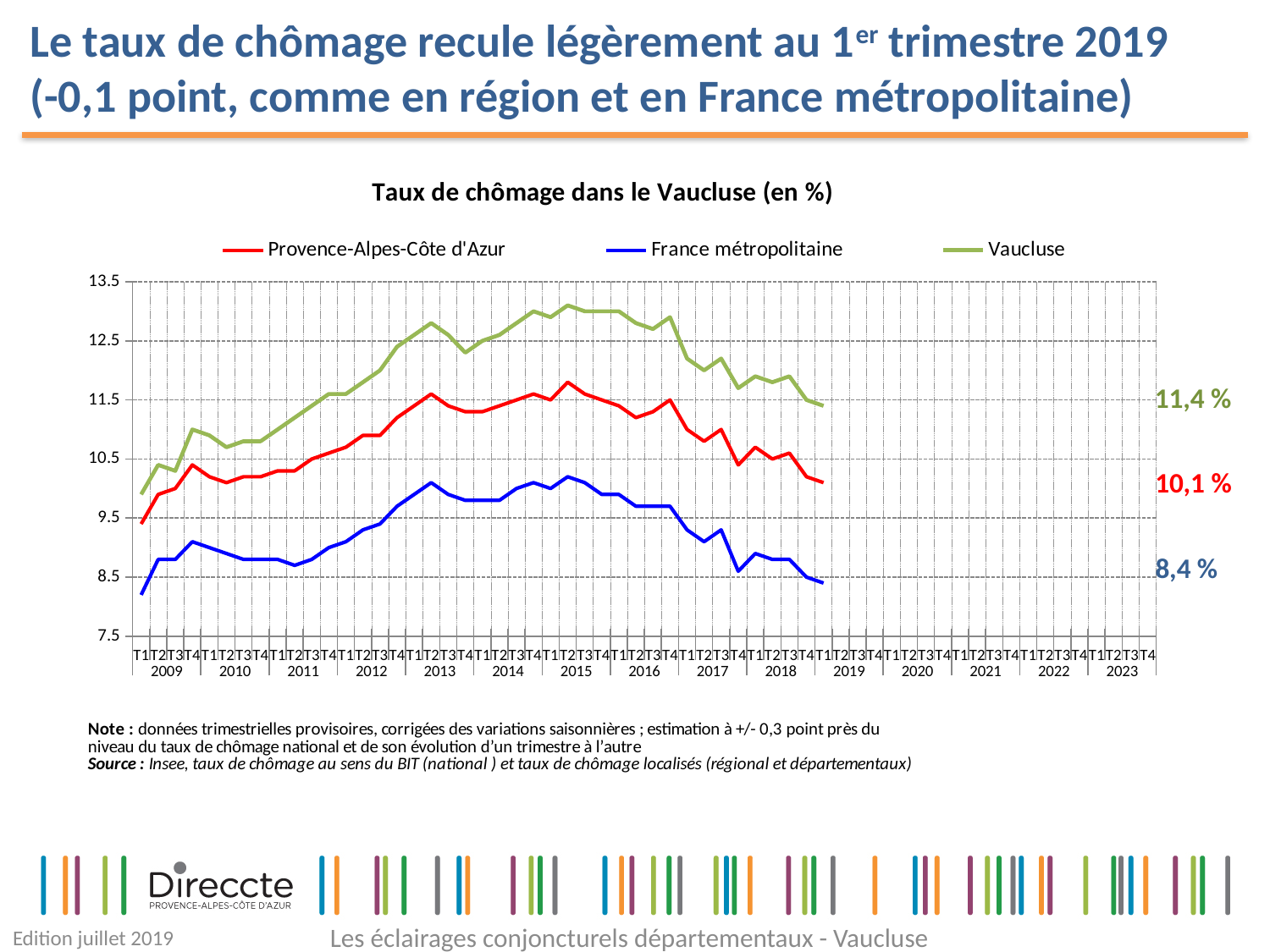
What is the latest value shown for Vaucluse at the end of the line? 11,4 % Is the value for France métropolitaine at T1 2009 greater or less than 8.5? less What is the difference between the latest Vaucluse value and the latest Provence-Alpes-Côte d'Azur value? 1,3 points Is the latest value for Provence-Alpes-Côte d'Azur larger or smaller than the latest value for France métropolitaine? larger Which series has the lowest value at the end of the lines (T1 2019)? France métropolitaine Which series has the highest value at the end of the lines (T1 2019)? Vaucluse What kind of chart is shown on the slide? line chart What is the latest value shown for Provence-Alpes-Côte d'Azur at the end of the line? 10,1 % Is the peak value of the Vaucluse line in 2015 greater or less than 12.5? greater How many series does the legend list? 3 What is the difference between the latest Vaucluse value and the latest France métropolitaine value? 3 points What is the latest value shown for France métropolitaine at the end of the line? 8,4 %